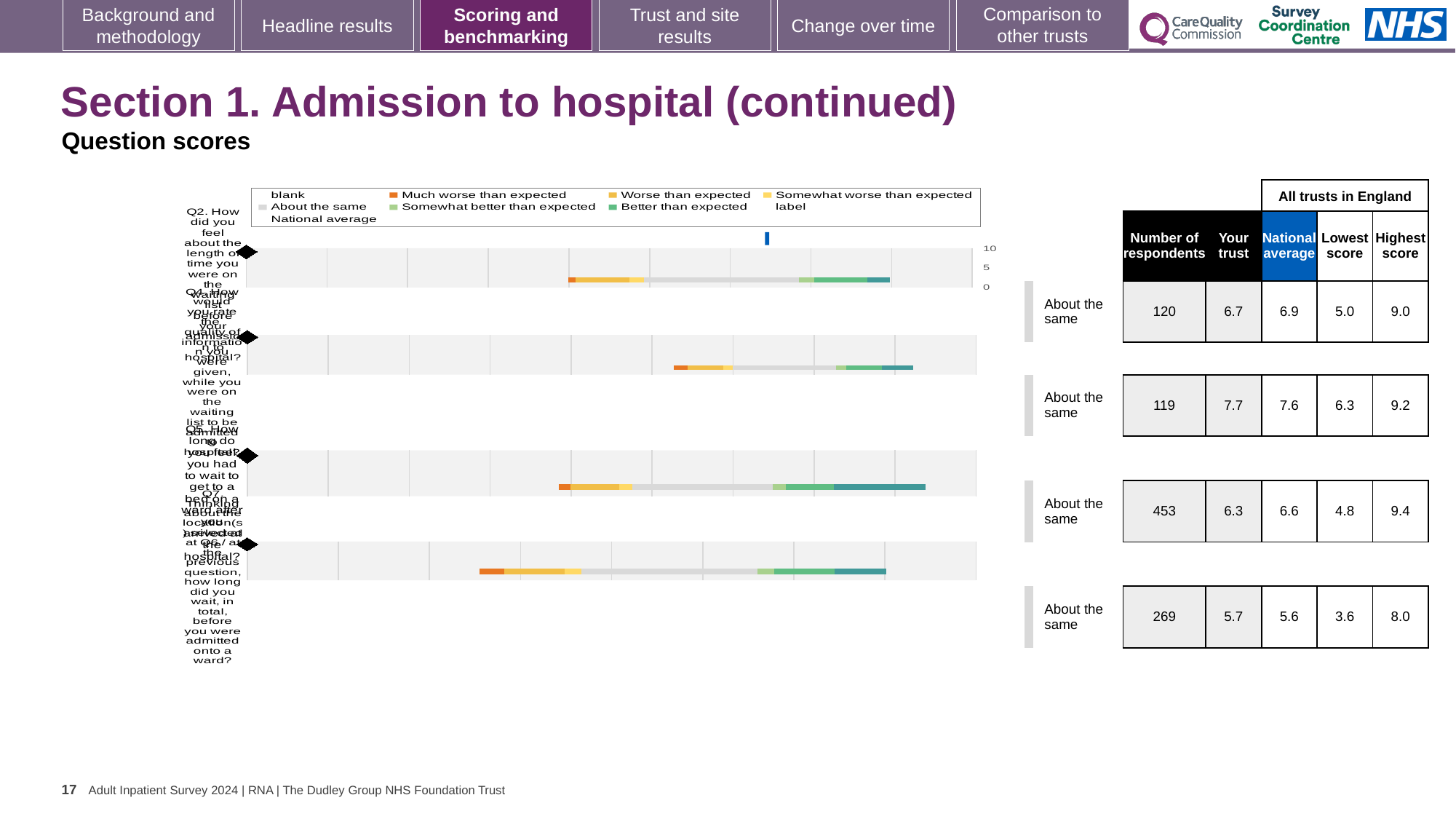
What benchmark label is shown next to each of the four bars? About the same In the table beside the chart, is the 'Your trust' score or the national average larger in the first row? National average In the table beside the chart, what is the highest score in the third row? 9.4 In the table beside the chart, which row has the largest number of respondents? third row (453) In the table beside the chart, what is the number of respondents in the first row? 120 In the table beside the chart, what is the national average in the fourth row? 5.6 What is the highest value shown on the chart's axis? 10 How many horizontal bars are plotted in the chart? 4 In the table beside the chart, what is the difference between the highest score and the lowest score in the third row? 4.6 In the table beside the chart, what is the 'Your trust' score in the second row? 7.7 In the table beside the chart, what is the lowest score in the fourth row? 3.6 What kind of chart is shown on the slide? bar chart